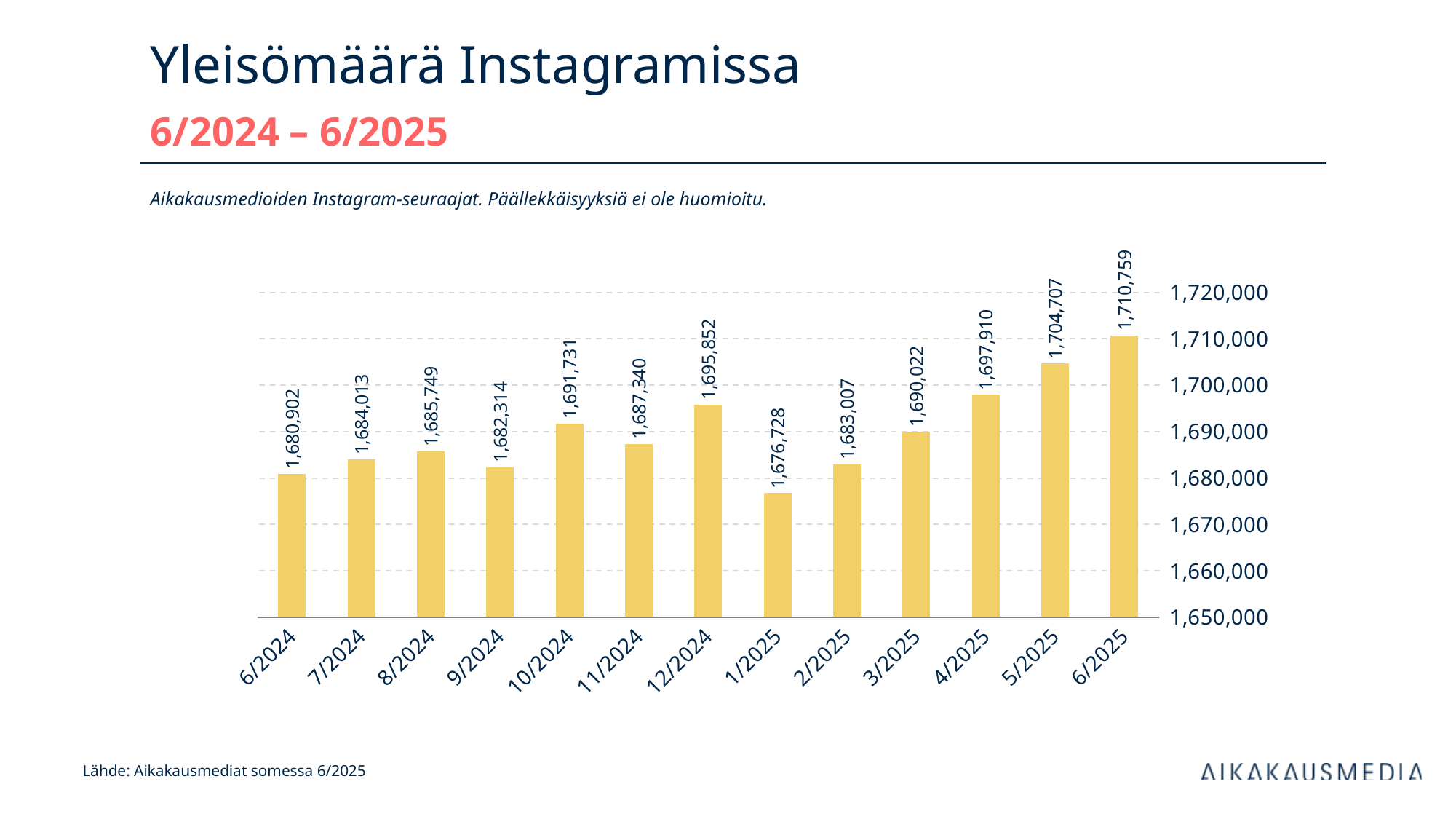
Which is larger, the value for 10/2024 or the value for 11/2024? 10/2024 How many months are shown on the x axis? 13 What is the difference between the values for 6/2025 and 6/2024? 29,857 What is the value for 12/2024? 1,695,852 What is the title of the slide? Yleisömäärä Instagramissa Which month has the highest value? 6/2025 What is the value for 6/2024? 1,680,902 Is the value for 5/2025 greater or less than 1,700,000? greater Which month has the lowest value? 1/2025 What is the difference between the values for 5/2025 and 4/2025? 6,797 What is the value for 1/2025? 1,676,728 What kind of chart is shown on the slide? bar chart